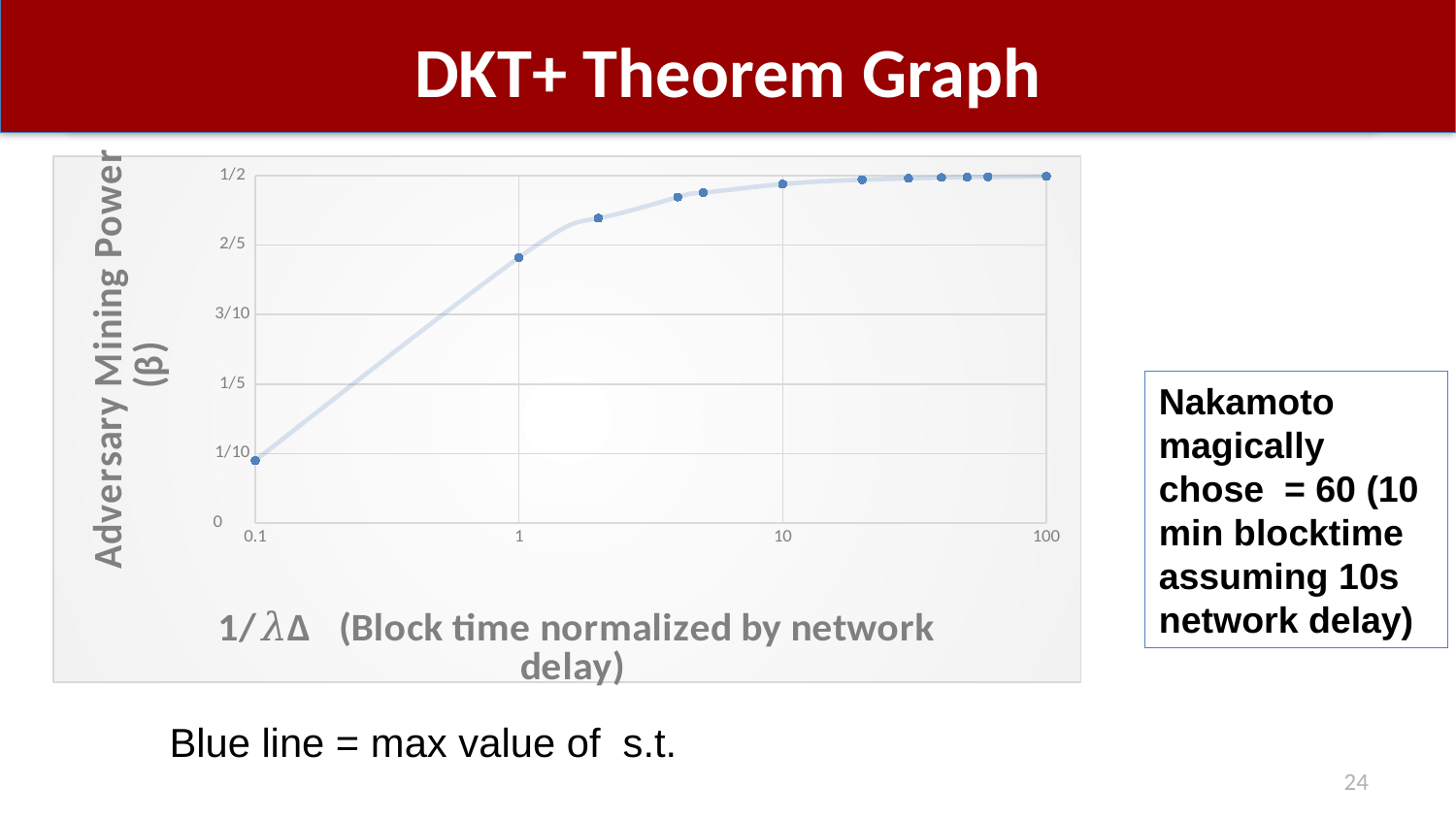
Do the plotted values rise or fall as the x-axis value increases from 0.1 to 100? rise What is the title of the chart? DKT+ Theorem Graph Is the value at x = 1 greater or less than 1/2? less How many tick labels are shown on the x-axis? 4 Is the value at x = 0.1 greater or less than 1/5? less What kind of chart is shown on the slide? line chart What is the label of the vertical axis? Adversary Mining Power (β) Is the value at x = 10 greater or less than 2/5? greater At which x-axis value is the plotted adversary mining power lowest? 0.1 Which has the larger plotted value, x = 0.1 or x = 1? 1 Which has the larger plotted value, x = 1 or x = 10? 10